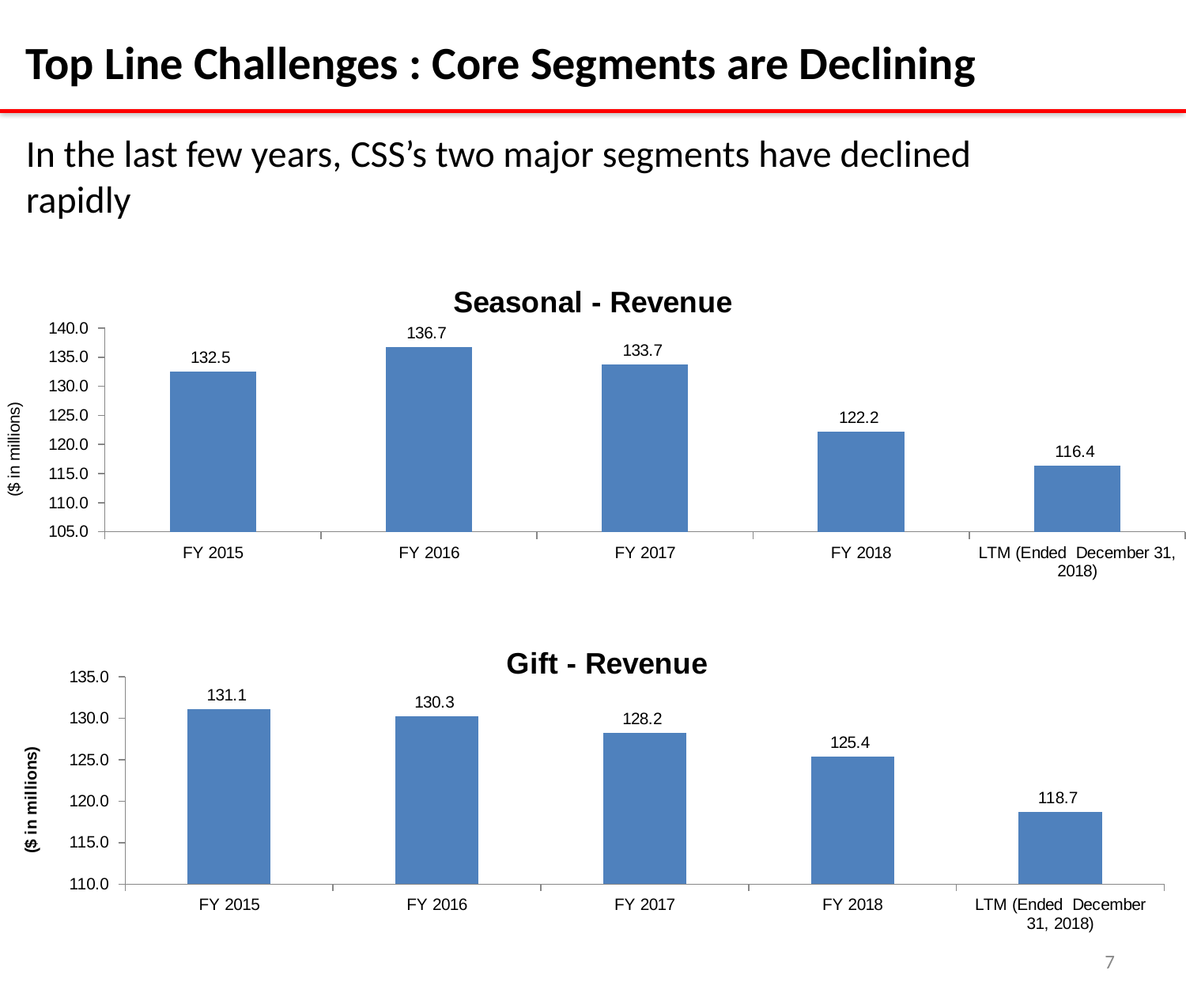
In the Seasonal - Revenue chart, what is the value for FY 2016? 136.7 In the Gift - Revenue chart, is the value for FY 2017 greater or less than 125.0? greater In the Gift - Revenue chart, do the values rise or fall from FY 2015 to LTM (Ended December 31, 2018)? fall In the Gift - Revenue chart, which category has the highest value? FY 2015 In the Seasonal - Revenue chart, which category has the highest value? FY 2016 What kind of chart is the Gift - Revenue chart? bar chart In the Gift - Revenue chart, what is the difference between FY 2015 and LTM (Ended December 31, 2018)? 12.4 In the Seasonal - Revenue chart, which category has the lowest value? LTM (Ended December 31, 2018) In the Seasonal - Revenue chart, what is the difference between FY 2017 and FY 2018? 11.5 In the Gift - Revenue chart, what is the value for FY 2018? 125.4 What is the y-axis label on the Seasonal - Revenue chart? ($ in millions) In the Seasonal - Revenue chart, how many bars are plotted? 5